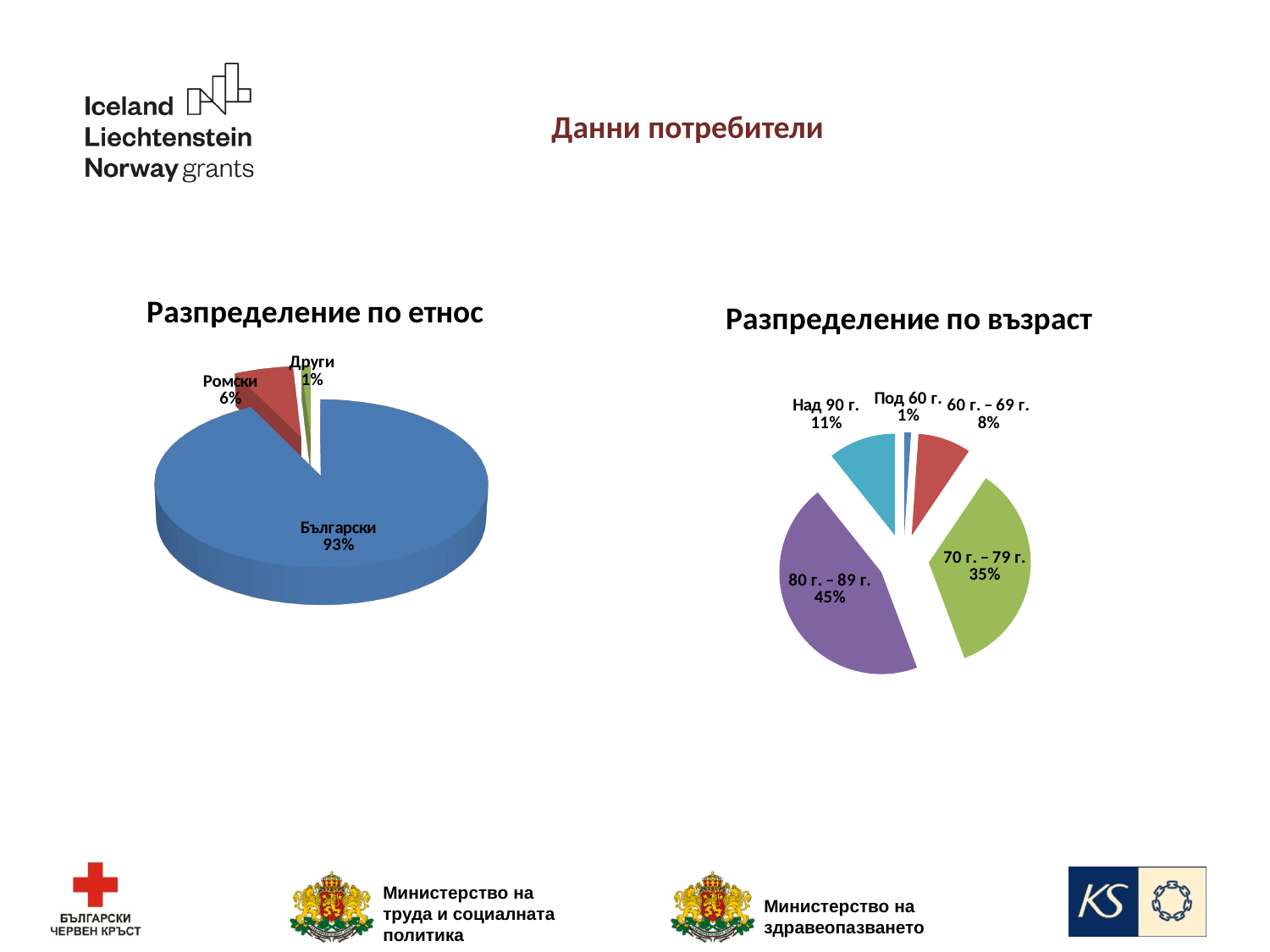
In the chart titled "Разпределение по възраст", what is the difference between the shares for 80 г. – 89 г. and 70 г. – 79 г.? 10% In the chart titled "Разпределение по етнос", what share is labelled for Ромски? 6% In the chart titled "Разпределение по възраст", how many age groups are shown? 5 In the chart titled "Разпределение по етнос", what is the difference between the shares for Български and Ромски? 87% In the chart titled "Разпределение по възраст", what share is labelled for Над 90 г.? 11% What kind of chart is the chart titled "Разпределение по възраст"? Pie chart In the chart titled "Разпределение по етнос", which category has the smallest share? Други In the chart titled "Разпределение по възраст", which is larger, the share for 70 г. – 79 г. or the share for 60 г. – 69 г.? 70 г. – 79 г. In the chart titled "Разпределение по етнос", what share is labelled for Български? 93% In the chart titled "Разпределение по възраст", which age group has the largest share? 80 г. – 89 г. In the chart titled "Разпределение по етнос", how many slices does the pie have? 3 In the chart titled "Разпределение по възраст", what share is labelled for 80 г. – 89 г.? 45%